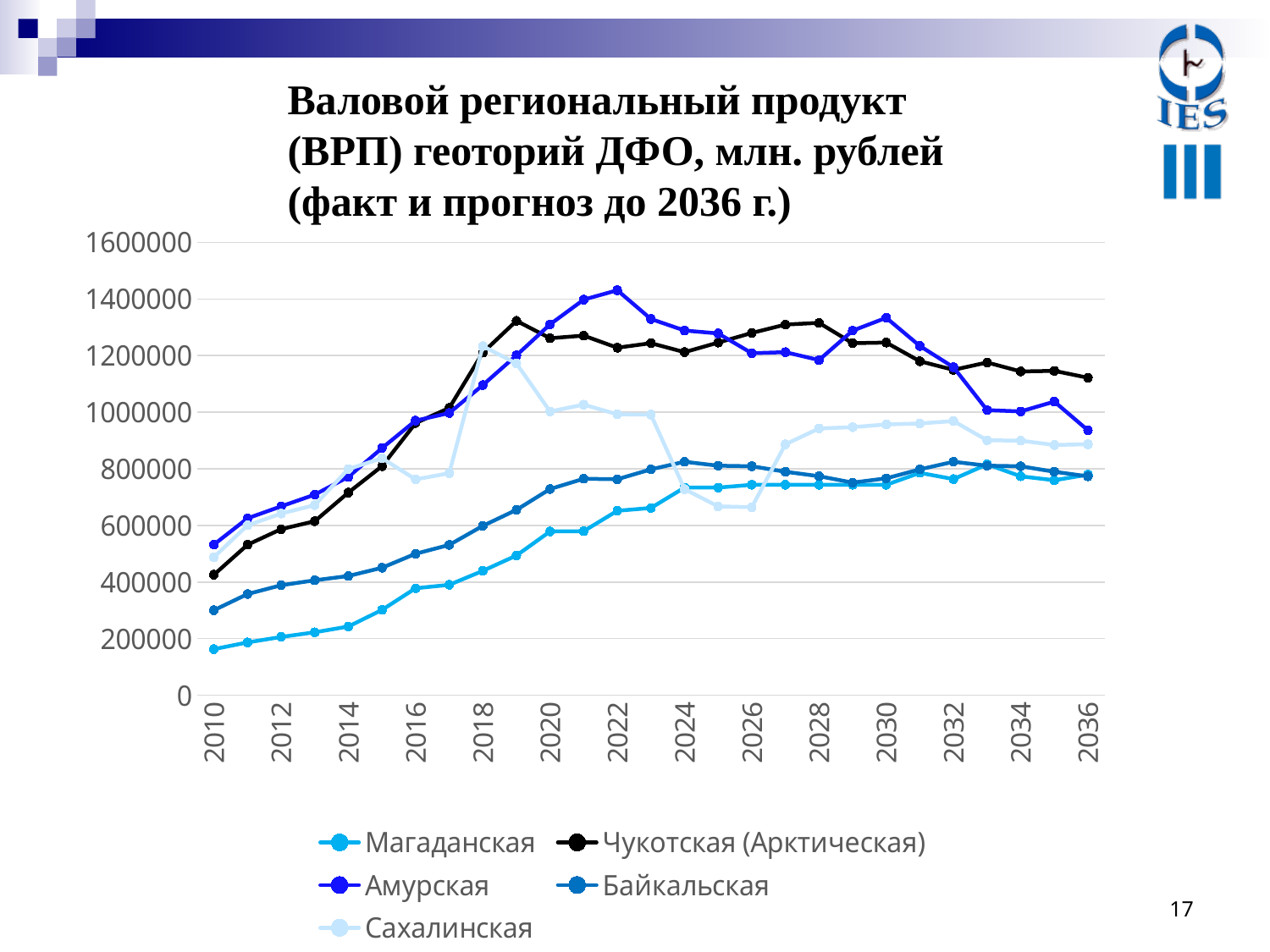
Is the value for Байкальская in 2020 greater or less than 800000? less What is the first year shown on the x axis? 2010 Which series has the highest value in 2036? Чукотская (Арктическая) Which series has the highest value in 2022? Амурская In 2020, which is larger: the value for Чукотская (Арктическая) or the value for Магаданская? Чукотская (Арктическая) Which series has the lowest value in 2010? Магаданская Is the value for Магаданская in 2010 greater or less than 200000? less Does the Магаданская series rise or fall from 2010 to 2024? rise Is the value for Сахалинская in 2026 greater or less than 800000? less What kind of chart is shown on the slide? line chart How many series does the legend list? 5